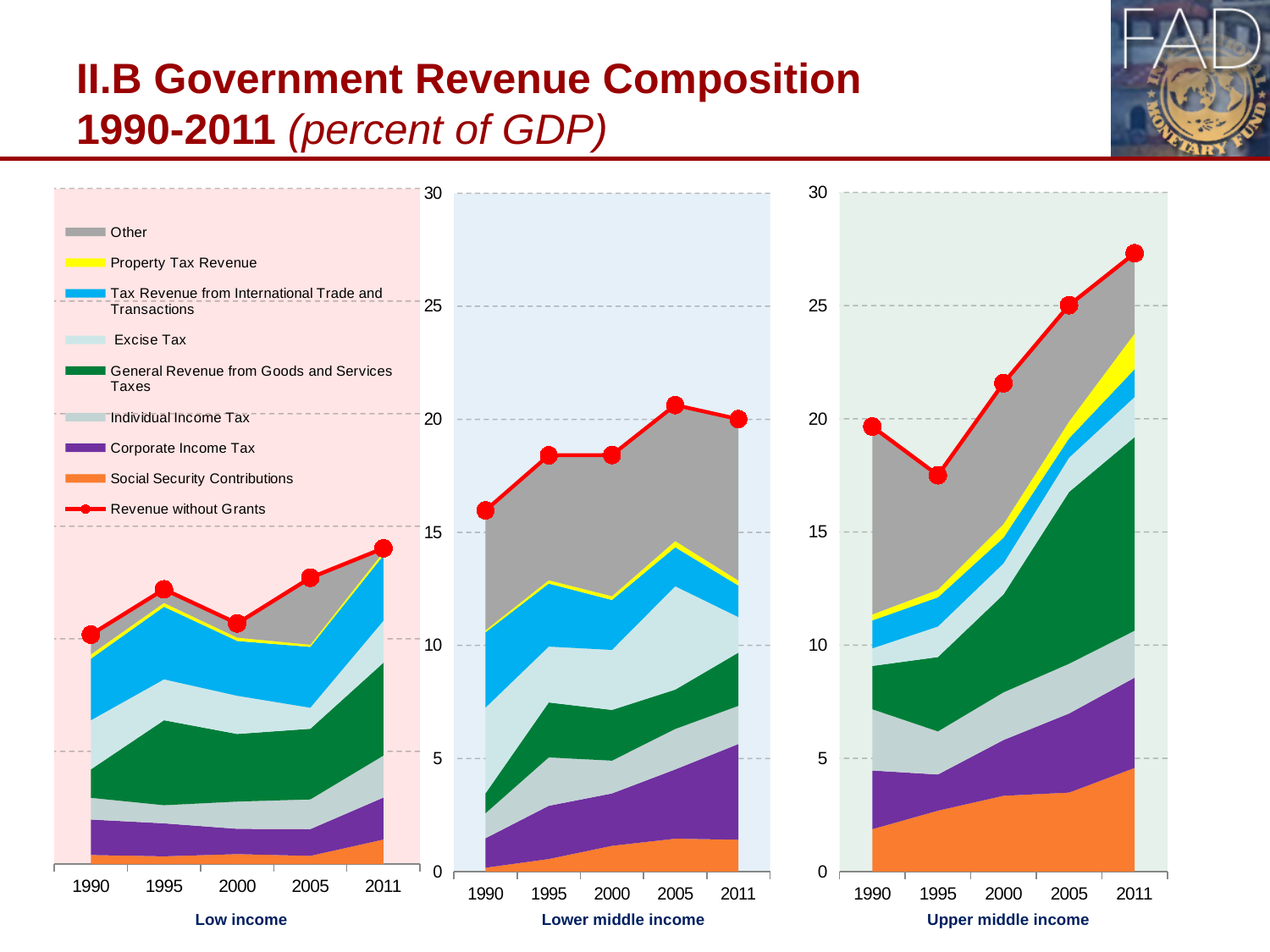
Which is larger in 2011: Revenue without Grants in the Upper middle income chart or in the Lower middle income chart? Upper middle income In the Upper middle income chart, does Revenue without Grants rise or fall from 2000 to 2011? Rise In the Upper middle income chart, which year has the lowest Revenue without Grants? 1995 What kind of chart is the Low income chart? Stacked area chart with a line In the Low income chart, is Revenue without Grants in 2011 greater or less than 15? less How many series does the legend list? 9 In the Lower middle income chart, is Revenue without Grants in 1990 greater or less than 15? greater In the Upper middle income chart, which year has the highest Revenue without Grants? 2011 In the Low income chart, which year has the lowest Revenue without Grants? 1990 How many years are plotted on the x axis of the Lower middle income chart? 5 In the Upper middle income chart, is Revenue without Grants in 2011 greater or less than 25? greater In the Lower middle income chart, which year has the highest Revenue without Grants? 2005